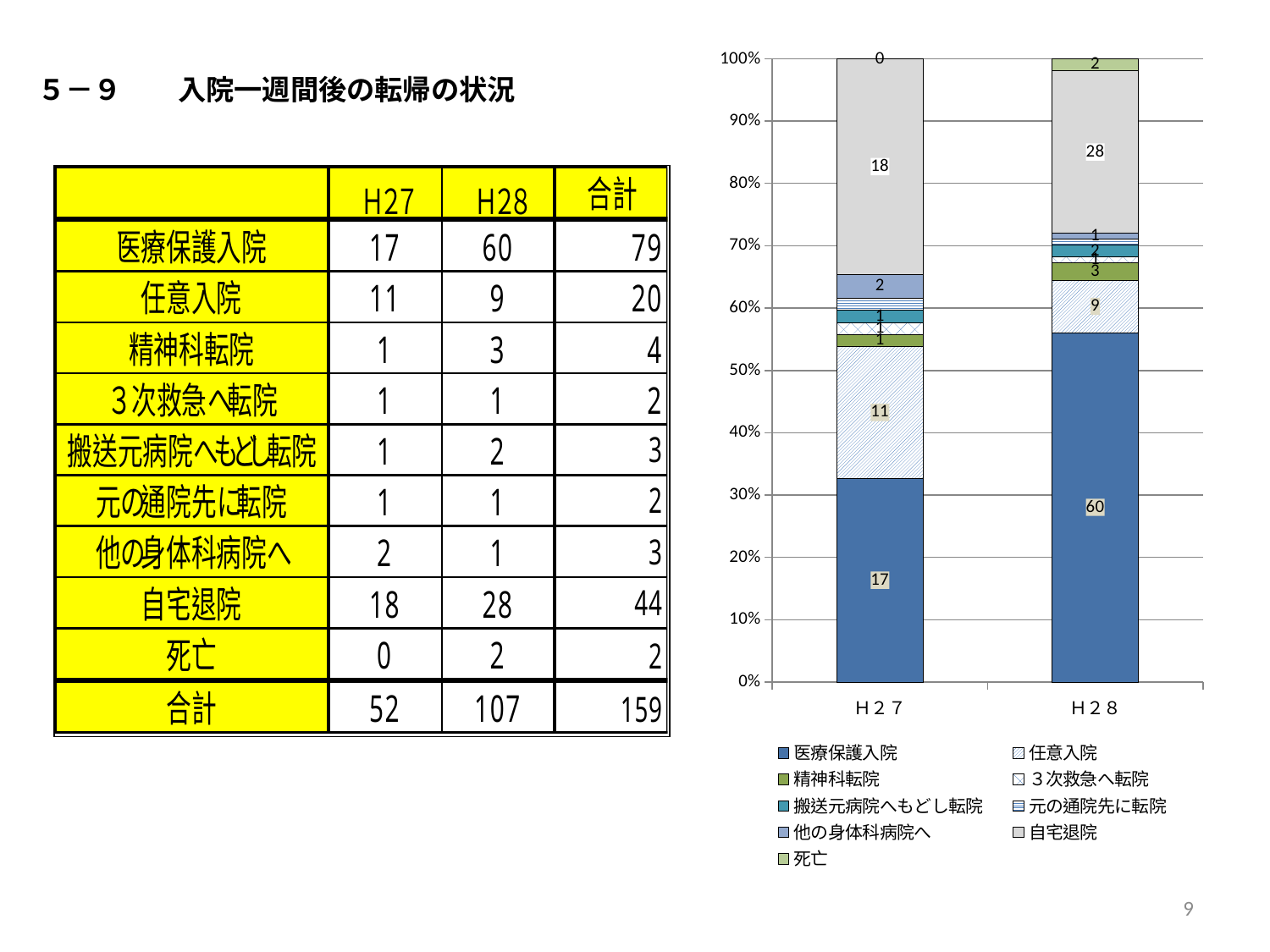
What is the value of 任意入院 for H28 in the chart? 9 Which year has the larger value for 医療保護入院, H27 or H28? H28 What is the value of 任意入院 for H27 in the chart? 11 What are the two category labels on the x axis of the chart? H27 and H28 What is the value of 医療保護入院 for H28 in the chart? 60 What kind of chart is shown on the slide? bar chart How many categories are shown on the x axis of the chart? 2 How many series does the chart legend list? 9 What is the value of 医療保護入院 for H27 in the chart? 17 What is the value of 自宅退院 for H28 in the chart? 28 What is the value of 死亡 for H27 in the chart? 0 What is the difference between the 自宅退院 values for H28 and H27? 10